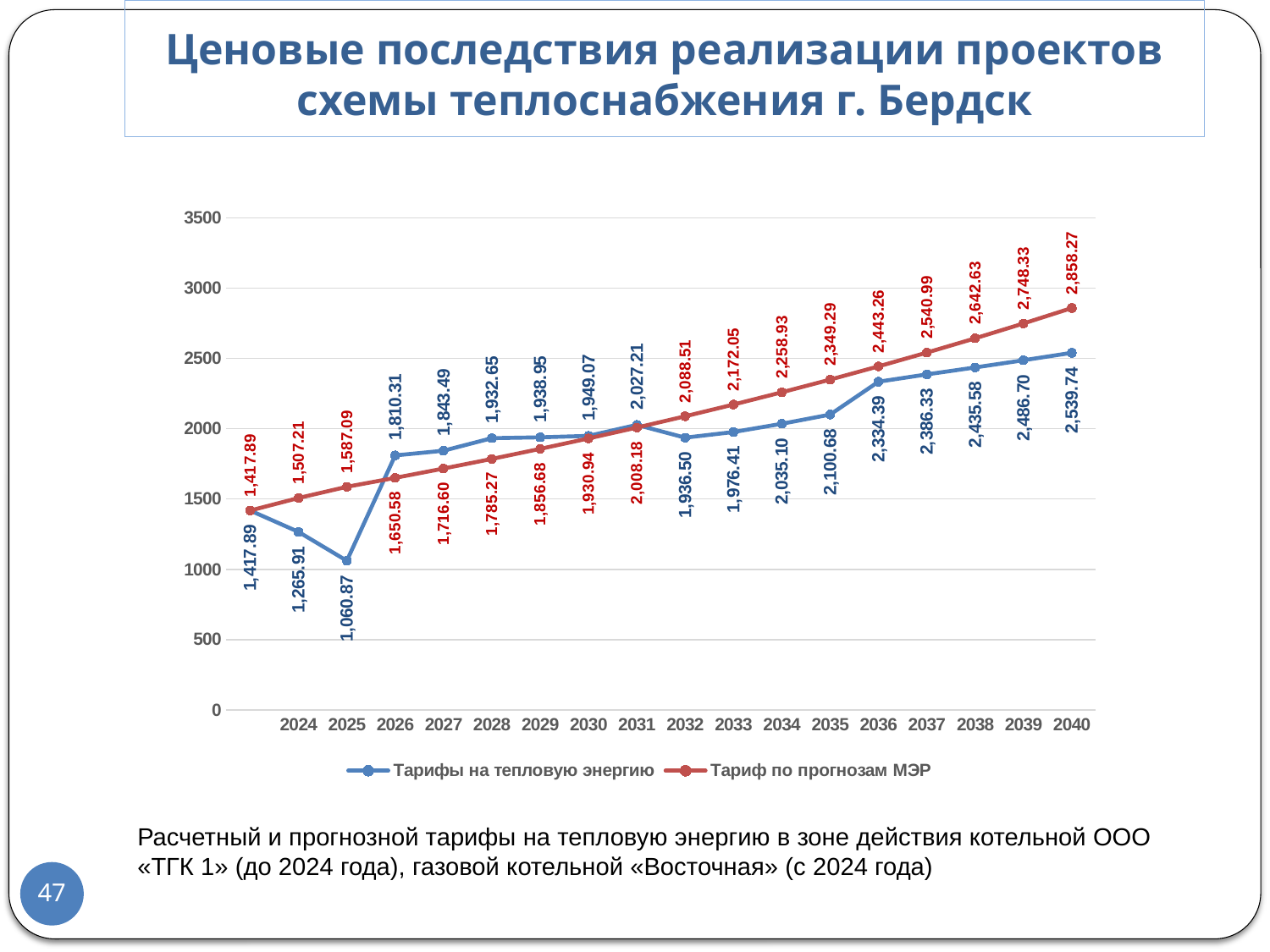
In 2036, which series has the larger value: 'Тарифы на тепловую энергию' or 'Тариф по прогнозам МЭР'? Тариф по прогнозам МЭР In which labelled year is 'Тарифы на тепловую энергию' at its lowest? 2025 What are the two series named in the legend? Тарифы на тепловую энергию; Тариф по прогнозам МЭР What is the value of 'Тарифы на тепловую энергию' in 2025? 1,060.87 How many series does the legend list? 2 What is the value of 'Тарифы на тепловую энергию' in 2040? 2,539.74 What kind of chart is shown on the slide? line chart Is the value of 'Тариф по прогнозам МЭР' in 2035 greater or less than 2000? greater In which year does 'Тариф по прогнозам МЭР' reach its highest value? 2040 What is the difference between 'Тариф по прогнозам МЭР' and 'Тарифы на тепловую энергию' in 2040? 318.53 What is the value of 'Тариф по прогнозам МЭР' in 2040? 2,858.27 Does 'Тариф по прогнозам МЭР' rise or fall from 2024 to 2040? rises